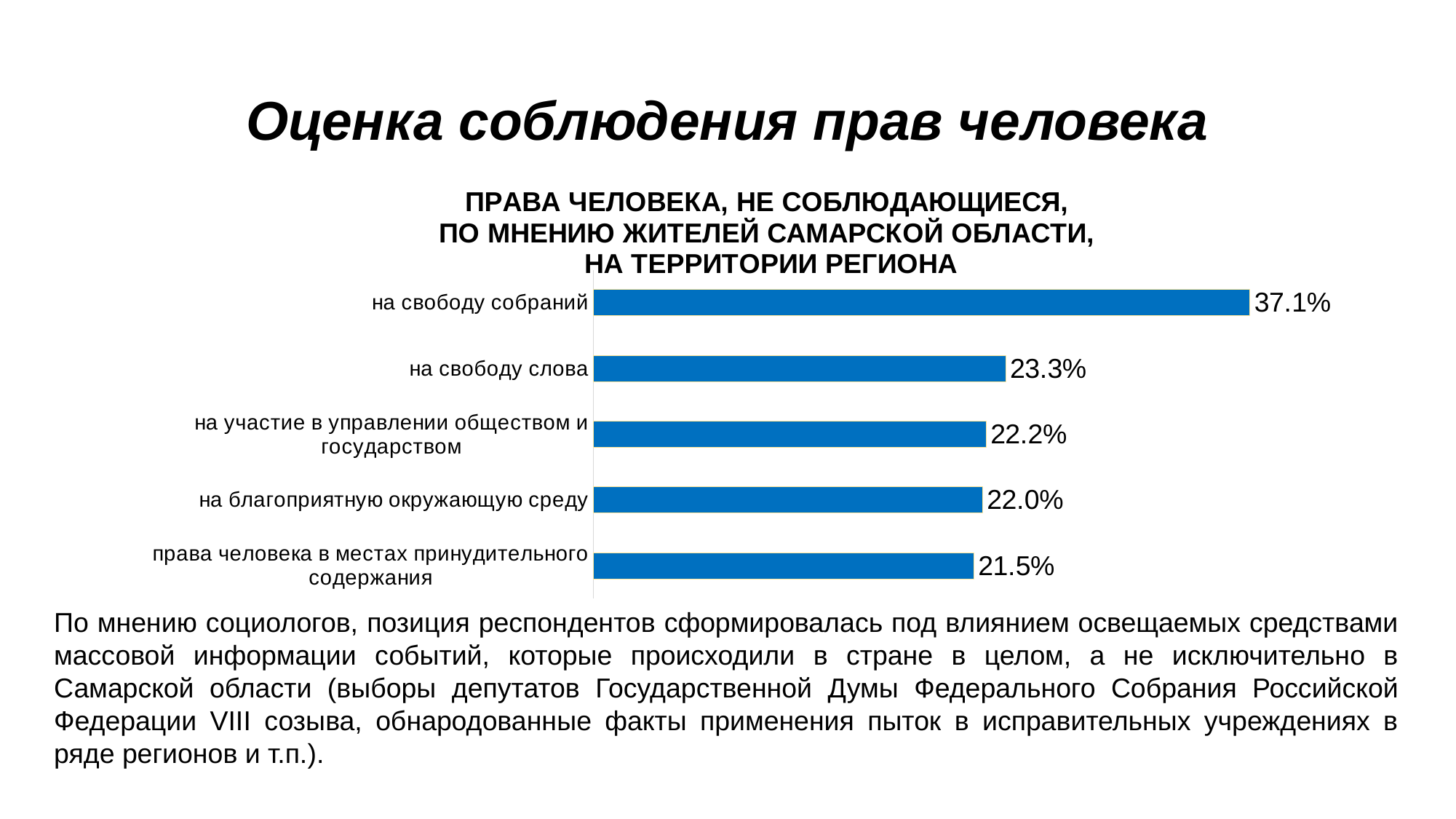
Which category has the highest value? на свободу собраний What is the difference between the values for "на участие в управлении обществом и государством" and "права человека в местах принудительного содержания"? 0.7% What is the value for "права человека в местах принудительного содержания"? 21.5% Which category has the lowest value? права человека в местах принудительного содержания What kind of chart is shown on the slide? bar chart What is the title of the chart? ПРАВА ЧЕЛОВЕКА, НЕ СОБЛЮДАЮЩИЕСЯ, ПО МНЕНИЮ ЖИТЕЛЕЙ САМАРСКОЙ ОБЛАСТИ, НА ТЕРРИТОРИИ РЕГИОНА What is the value for "на свободу собраний"? 37.1% What is the value for "на свободу слова"? 23.3% Which is larger: the value for "на свободу слова" or the value for "на благоприятную окружающую среду"? на свободу слова What is the difference between the values for "на свободу собраний" and "на свободу слова"? 13.8% What is the value for "на благоприятную окружающую среду"? 22.0% How many categories are shown in the chart? 5